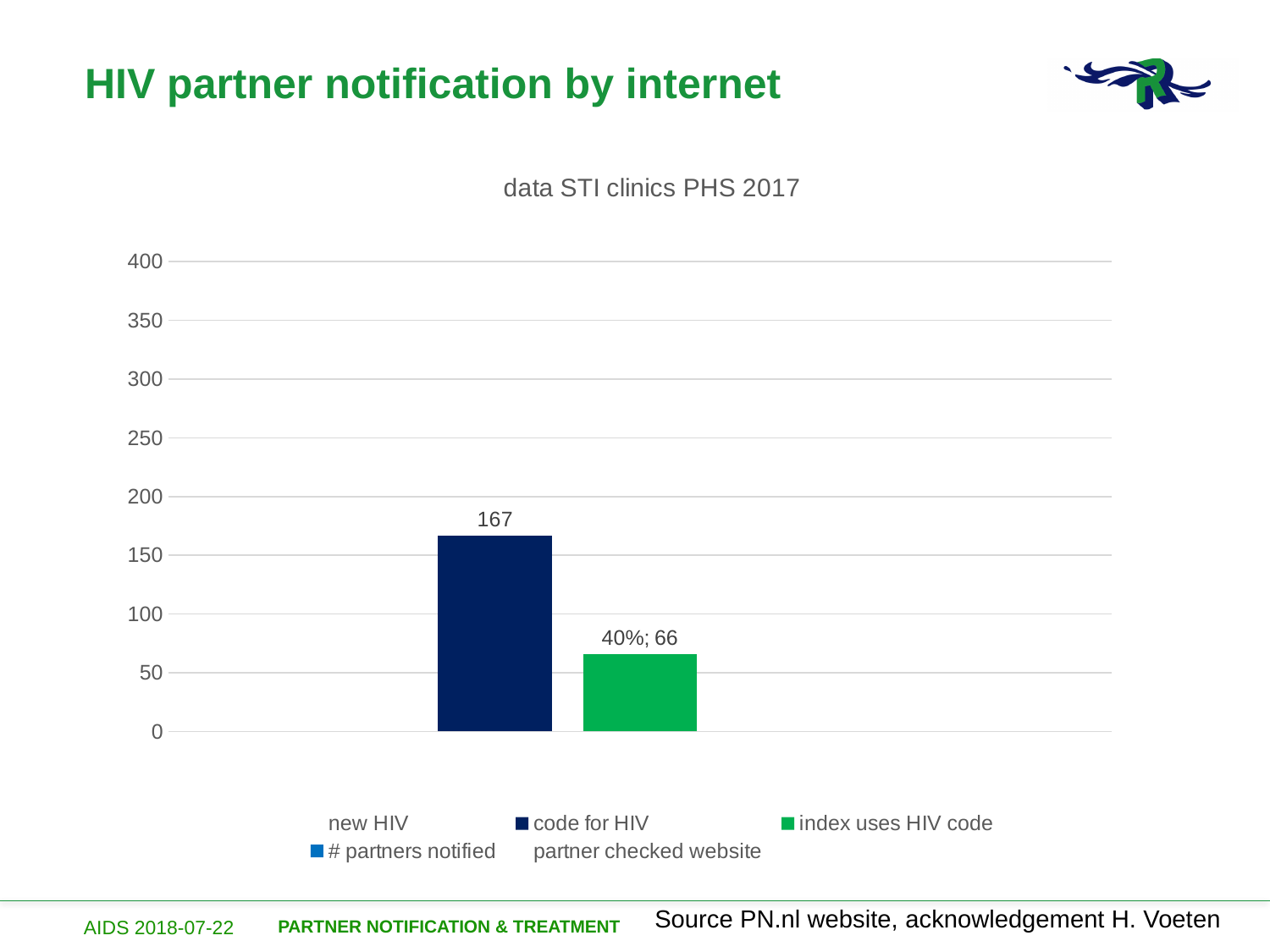
Is the value for 'code for HIV' greater or less than 200? less What is the value of the 'code for HIV' bar? 167 Is the value for 'index uses HIV code' greater or less than 50? greater Which series has the tallest bar in the chart? code for HIV What is the difference between the 'code for HIV' value (167) and the 'index uses HIV code' count (66)? 101 How many series does the legend list? 5 What kind of chart is shown on the slide? bar chart Which is larger, the 'code for HIV' bar or the 'index uses HIV code' bar? code for HIV What is the title of the chart? data STI clinics PHS 2017 What colour is the 'index uses HIV code' bar? green Which of the two plotted bars is the shortest? index uses HIV code What data label is shown on the 'index uses HIV code' bar? 40%; 66